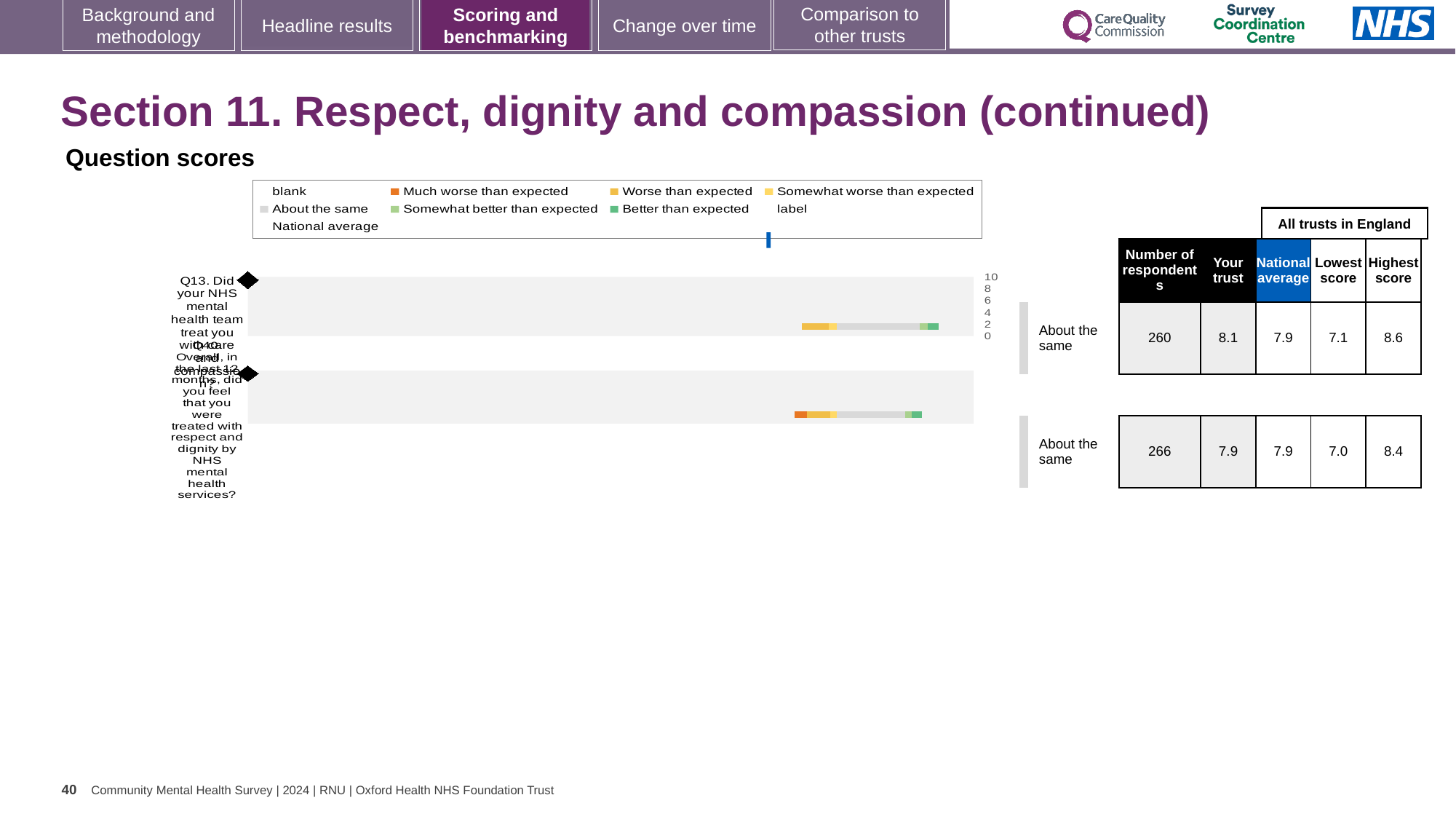
How many more respondents answered Q14 than Q13? 6 What is the highest score among all trusts in England for Q14? 8.4 How many questions are plotted in the question scores chart? 2 What is the difference between the highest score and the lowest score for Q13? 1.5 For Q13, is the 'Your trust' score higher or lower than the national average? higher What kind of chart is used to show the question scores on this slide? bar chart What is the national average score for Q13? 7.9 What is the 'Your trust' score for Q13 in the table beside the chart? 8.1 Which question has the higher 'Your trust' score, Q13 or Q14? Q13 What is the lowest score among all trusts in England for Q14? 7.0 What is the number of respondents for Q14? 266 What benchmark category is shown next to the chart for Q14? About the same